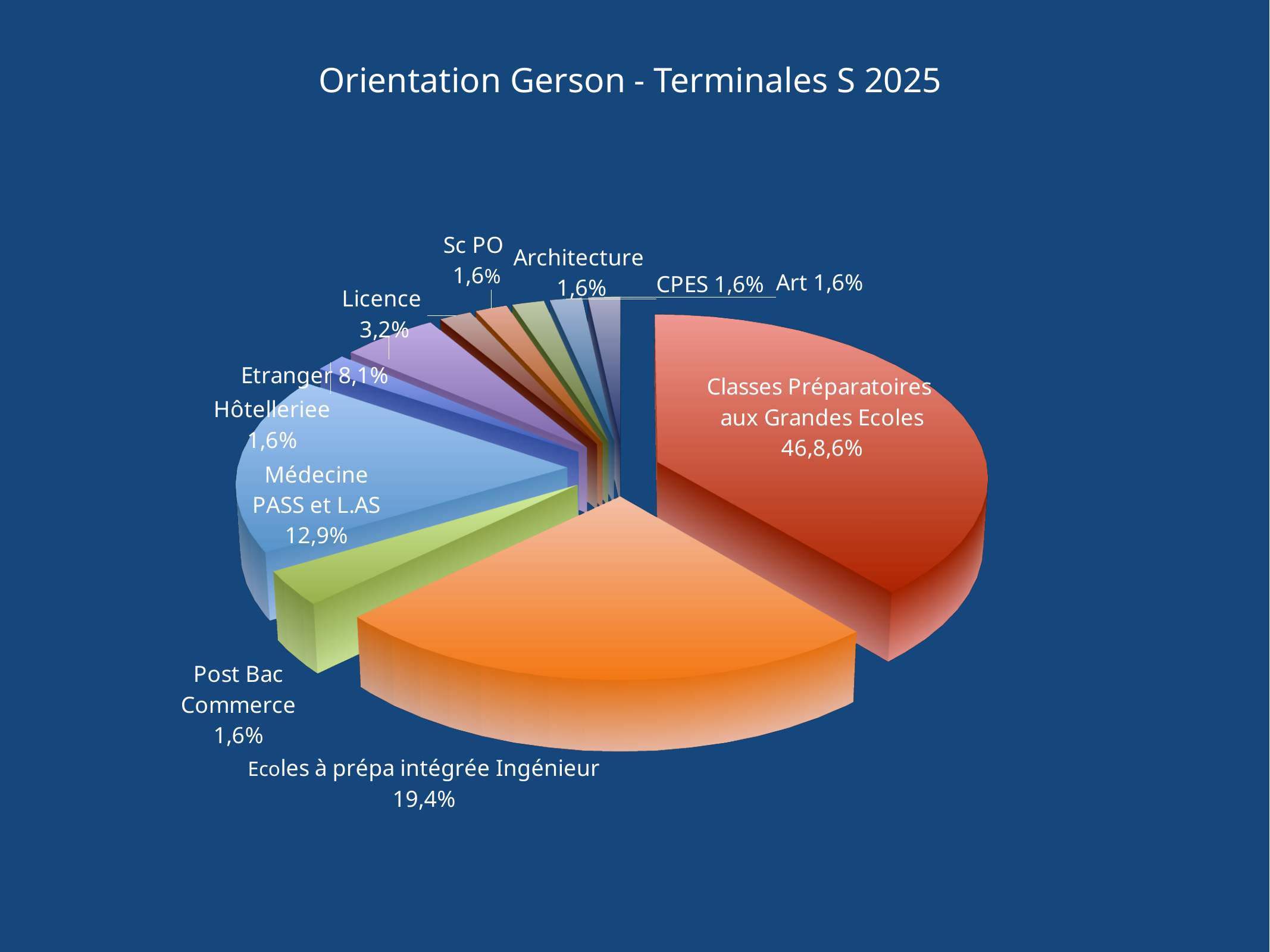
What kind of chart is shown on the slide? pie chart Which category has the largest slice of the pie? Classes Préparatoires aux Grandes Ecoles What percentage is shown for Médecine PASS et L.AS? 12,9% What is the difference in percentage points between Etranger and Licence? 4,9% What percentage is shown for Etranger? 8,1% Which is larger, the share for Médecine PASS et L.AS or the share for Etranger? Médecine PASS et L.AS What percentage is shown for Sc PO? 1,6% What is the title of the chart? Orientation Gerson - Terminales S 2025 What is the difference in percentage points between Ecoles à prépa intégrée Ingénieur and Médecine PASS et L.AS? 6,5% What share of the pie is labelled for Ecoles à prépa intégrée Ingénieur? 19,4% How many categories (slices) are labelled in the pie chart? 11 What percentage is shown for Licence? 3,2%